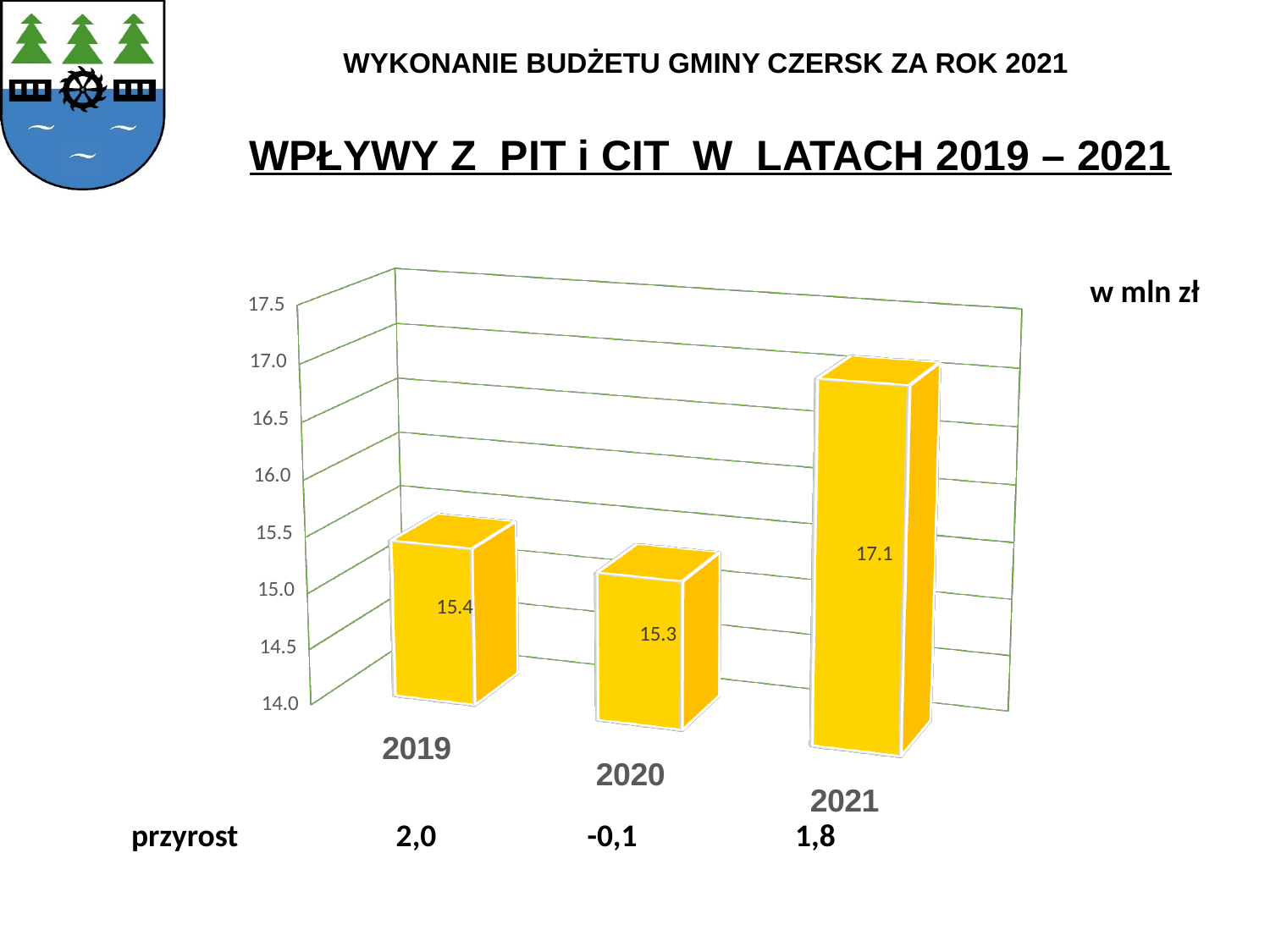
What is the difference between the values for 2021 and 2019? 1.7 What is the value for 2020? 15.3 What is the difference between the values for 2021 and 2020? 1.8 What is the value for 2019? 15.4 Is the value for 2021 greater or less than 16.0? greater Which year has the highest value? 2021 What unit is indicated for the chart values? w mln zł What is the value for 2021? 17.1 How many years are shown in the chart? 3 Is the value for 2020 greater or less than 16.0? less Which is larger, the value for 2021 or the value for 2020? 2021 What kind of chart is shown on the slide? bar chart